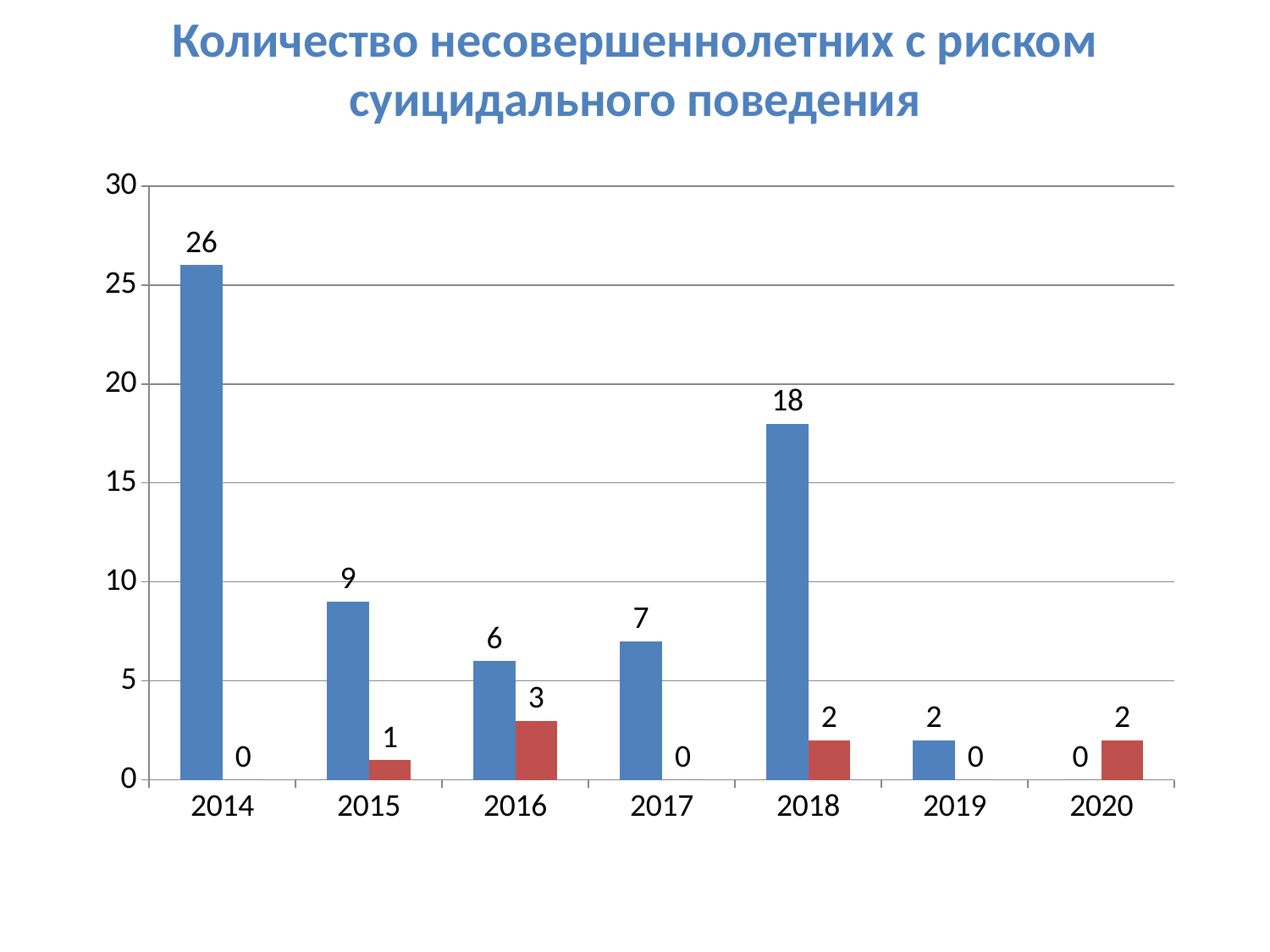
Which is larger, the blue bar for 2016 or the blue bar for 2017? 2017 What type of chart is shown on the slide? Bar chart What is the value of the red bar for 2020? 2 What is the value of the red bar for 2016? 3 What is the value of the blue bar for 2018? 18 What is the difference between the blue and red bar values for 2015? 8 Which year has the highest blue bar? 2014 Which year has the highest red bar? 2016 How many years are shown on the x axis? 7 What is the title of the chart? Количество несовершеннолетних с риском суицидального поведения What is the value of the blue bar for 2014? 26 What is the difference between the blue bar values for 2014 and 2018? 8